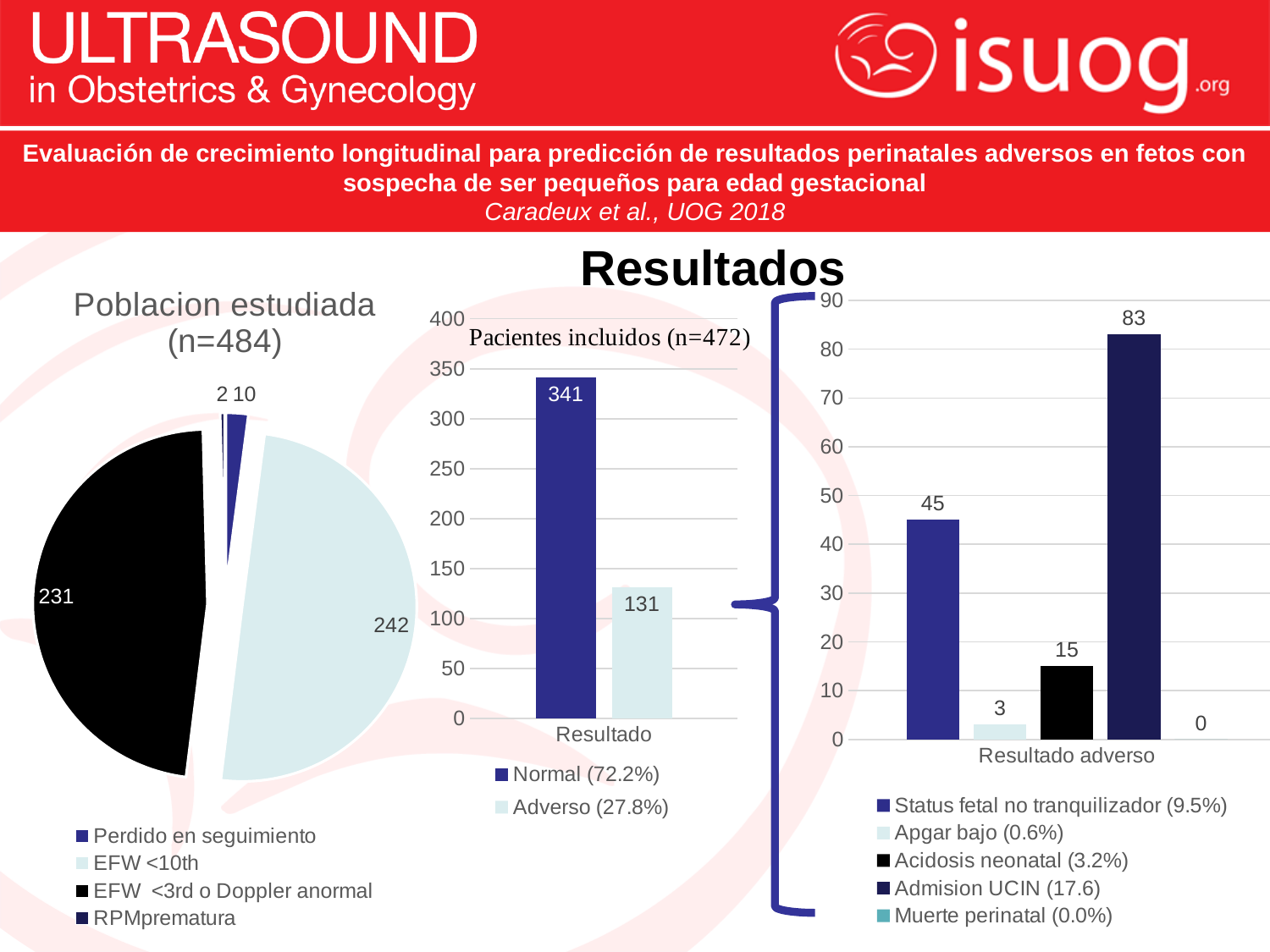
In the right-hand 'Resultado adverso' chart, which is larger: Status fetal no tranquilizador or Acidosis neonatal? Status fetal no tranquilizador In the 'Pacientes incluidos (n=472)' chart, what is the difference between the Normal and Adverso values? 210 How many series does the legend of the right-hand 'Resultado adverso' chart list? 5 In the 'Pacientes incluidos (n=472)' chart, what is the value for Adverso? 131 What kind of chart is the 'Poblacion estudiada (n=484)' chart on the left? Pie chart In the 'Poblacion estudiada (n=484)' pie chart, what is the value for EFW <10th? 242 In the right-hand 'Resultado adverso' chart, which category has the highest value? Admision UCIN In the 'Poblacion estudiada (n=484)' pie chart, what is the value for EFW <3rd o Doppler anormal? 231 In the 'Pacientes incluidos (n=472)' chart, what is the value for Normal? 341 In the right-hand 'Resultado adverso' chart, what is the value for Admision UCIN? 83 In the right-hand 'Resultado adverso' chart, which category has the lowest value? Muerte perinatal In the right-hand 'Resultado adverso' chart, what is the value for Apgar bajo? 3